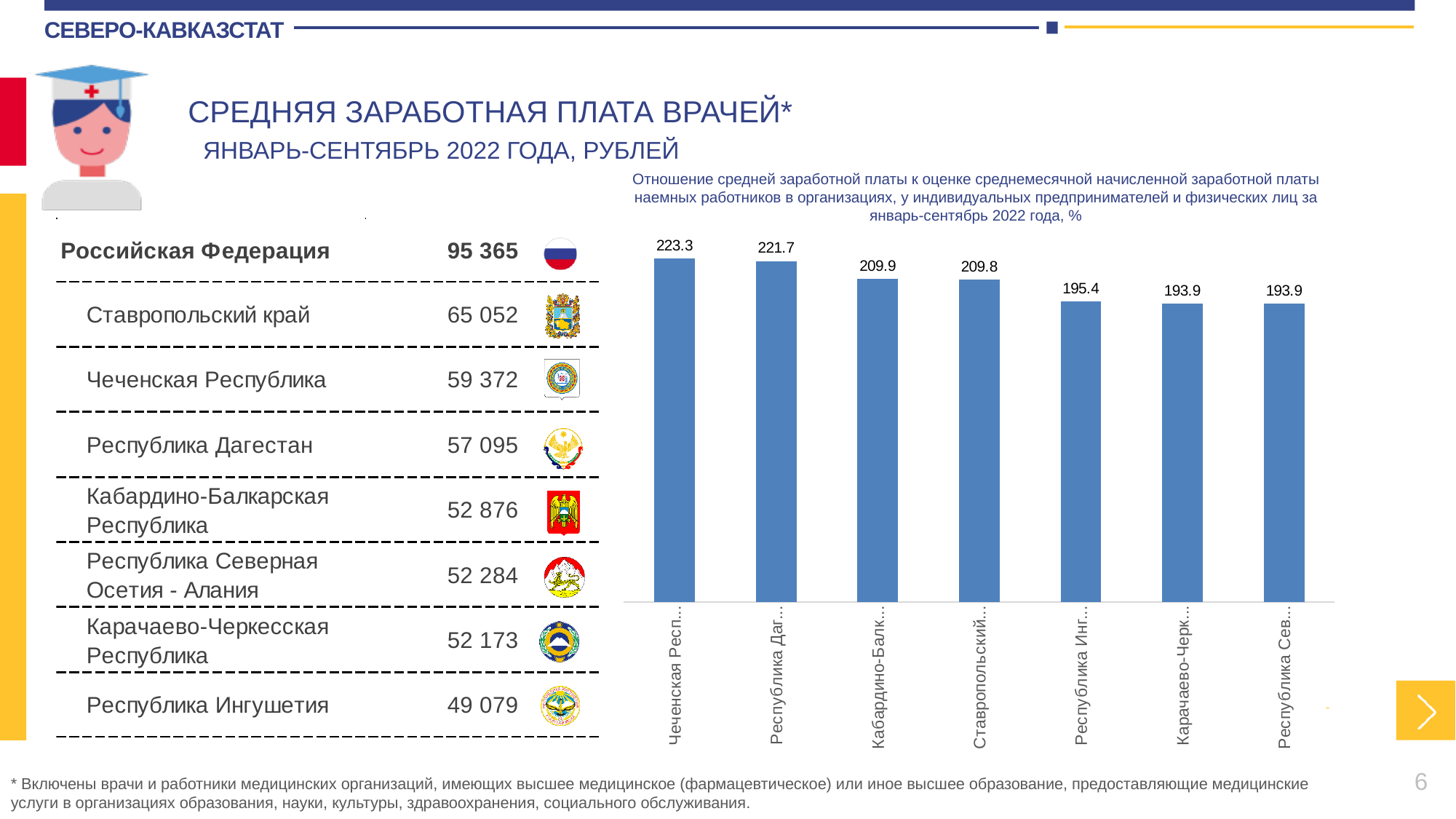
How many bars (regions) are plotted in the chart on the right? 7 In the chart on the right, what is the value for Республика Ингушетия? 195.4 In the chart on the right, which is larger: the value for Республика Дагестан or for Республика Ингушетия? Республика Дагестан What kind of chart is shown on the right side of the slide? bar chart In the chart on the right, what is the difference between the values for Чеченская Республика and Республика Ингушетия? 27.9 In the chart on the right, which region has the highest value? Чеченская Республика In the chart on the right, what is the value for Республика Дагестан? 221.7 In the chart on the right, what is the lowest value shown? 193.9 In the chart on the right, do the values rise or fall from left to right? fall In the chart on the right, what is the value for Кабардино-Балкарская Республика? 209.9 In the chart on the right, what is the value for Ставропольский край? 209.8 In the chart on the right, what is the difference between the values for Чеченская Республика and Республика Дагестан? 1.6